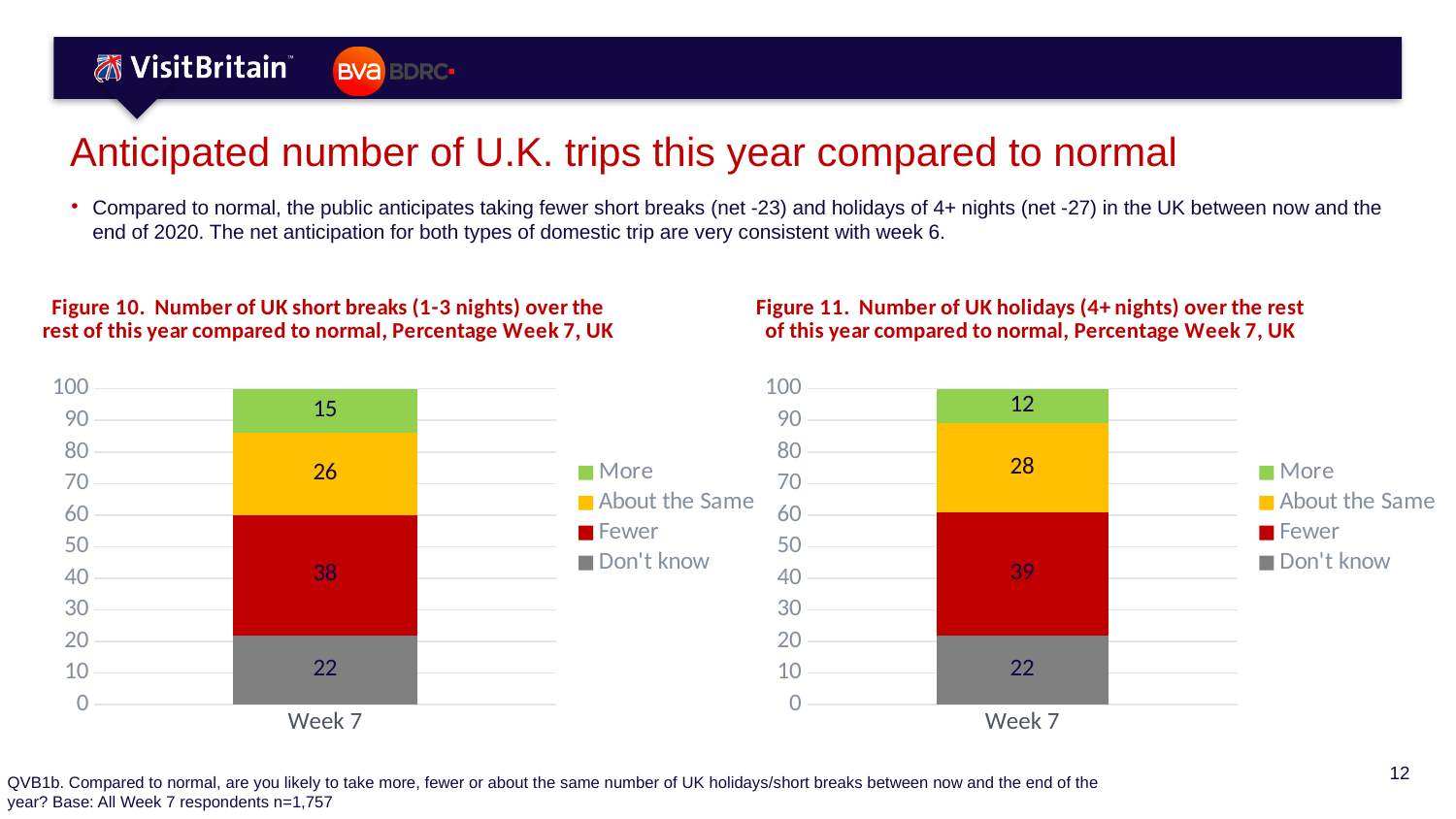
How many series does the legend list in Figure 10 (UK short breaks)? 4 In Figure 11 (UK holidays 4+ nights), what is the difference between the 'Fewer' and 'About the Same' values? 11 In Figure 11 (UK holidays 4+ nights), what is the value for 'Don't know'? 22 In Figure 10 (UK short breaks), what is the value for 'About the Same'? 26 What kind of chart is Figure 11 (UK holidays 4+ nights)? Stacked bar chart In Figure 11 (UK holidays 4+ nights), what is the value for 'More' in Week 7? 12 In Figure 10 (UK short breaks), which response category has the highest value? Fewer In Figure 10 (UK short breaks), what is the value for 'Fewer' in Week 7? 38 In Figure 10 (UK short breaks), which colour represents 'Fewer'? Red In Figure 11 (UK holidays 4+ nights), which response category has the lowest value? More Which is larger: the 'About the Same' value in Figure 10 or the 'About the Same' value in Figure 11? Figure 11 In Figure 10 (UK short breaks), what is the difference between the 'Fewer' and 'More' values? 23